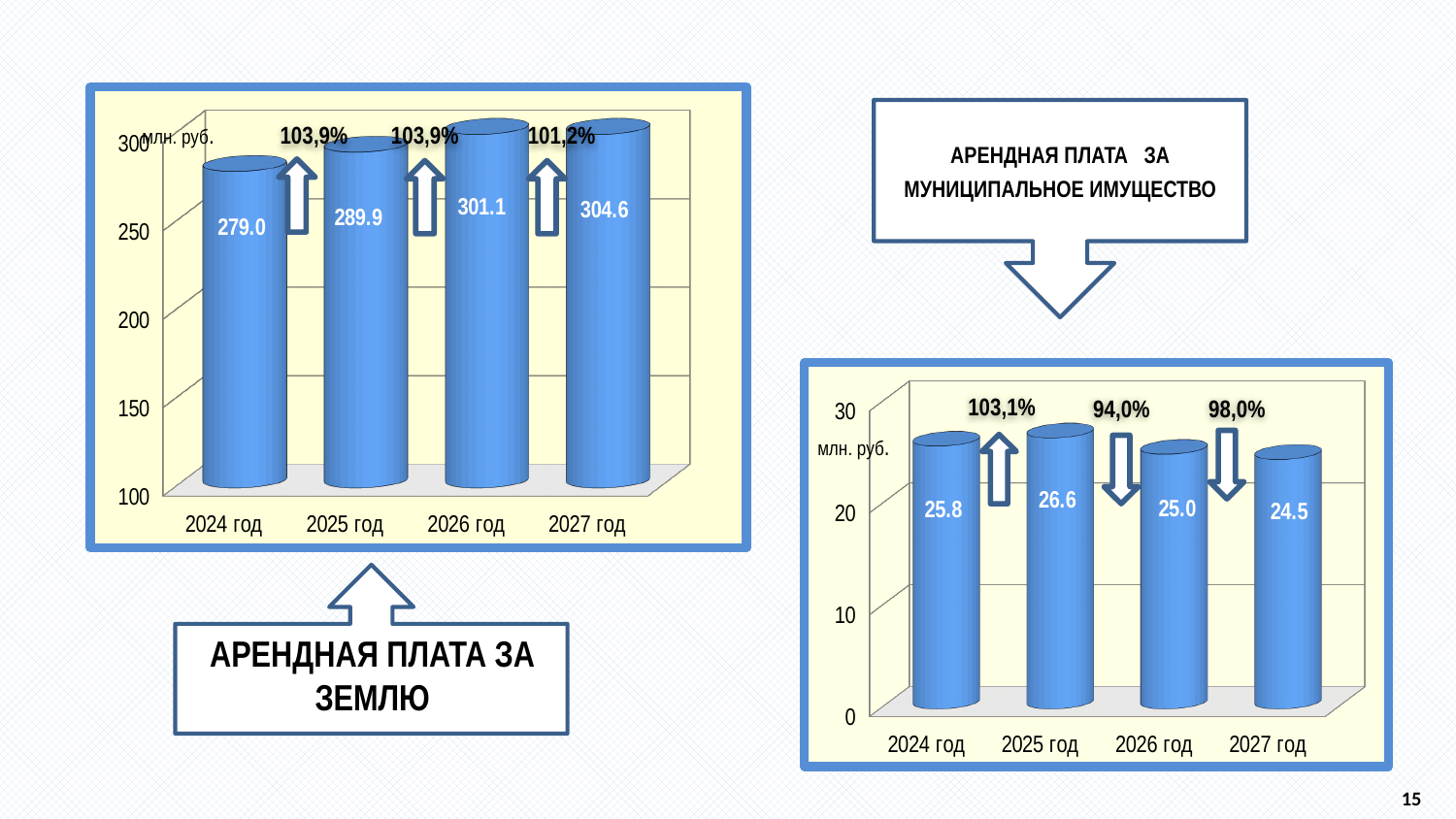
How many years (categories) are shown in the right chart (АРЕНДНАЯ ПЛАТА ЗА МУНИЦИПАЛЬНОЕ ИМУЩЕСТВО)? 4 In the right chart (АРЕНДНАЯ ПЛАТА ЗА МУНИЦИПАЛЬНОЕ ИМУЩЕСТВО), which is larger, the value for 2024 год or 2026 год? 2024 год In the left chart (АРЕНДНАЯ ПЛАТА ЗА ЗЕМЛЮ), which year has the lowest value? 2024 год In the left chart (АРЕНДНАЯ ПЛАТА ЗА ЗЕМЛЮ), what is the value for 2025 год? 289.9 In the left chart (АРЕНДНАЯ ПЛАТА ЗА ЗЕМЛЮ), what is the difference between the values for 2027 год and 2024 год? 25.6 In the right chart (АРЕНДНАЯ ПЛАТА ЗА МУНИЦИПАЛЬНОЕ ИМУЩЕСТВО), what is the value for 2026 год? 25.0 In the left chart (АРЕНДНАЯ ПЛАТА ЗА ЗЕМЛЮ), what percentage is shown above the arrow between 2026 год and 2027 год? 101,2% In the right chart (АРЕНДНАЯ ПЛАТА ЗА МУНИЦИПАЛЬНОЕ ИМУЩЕСТВО), which year has the lowest value? 2027 год What kind of chart is the left chart (АРЕНДНАЯ ПЛАТА ЗА ЗЕМЛЮ)? bar chart In the right chart (АРЕНДНАЯ ПЛАТА ЗА МУНИЦИПАЛЬНОЕ ИМУЩЕСТВО), which year has the highest value? 2025 год In the left chart (АРЕНДНАЯ ПЛАТА ЗА ЗЕМЛЮ), do the values rise or fall from 2024 год to 2027 год? rise In the left chart (АРЕНДНАЯ ПЛАТА ЗА ЗЕМЛЮ), which year has the highest value? 2027 год